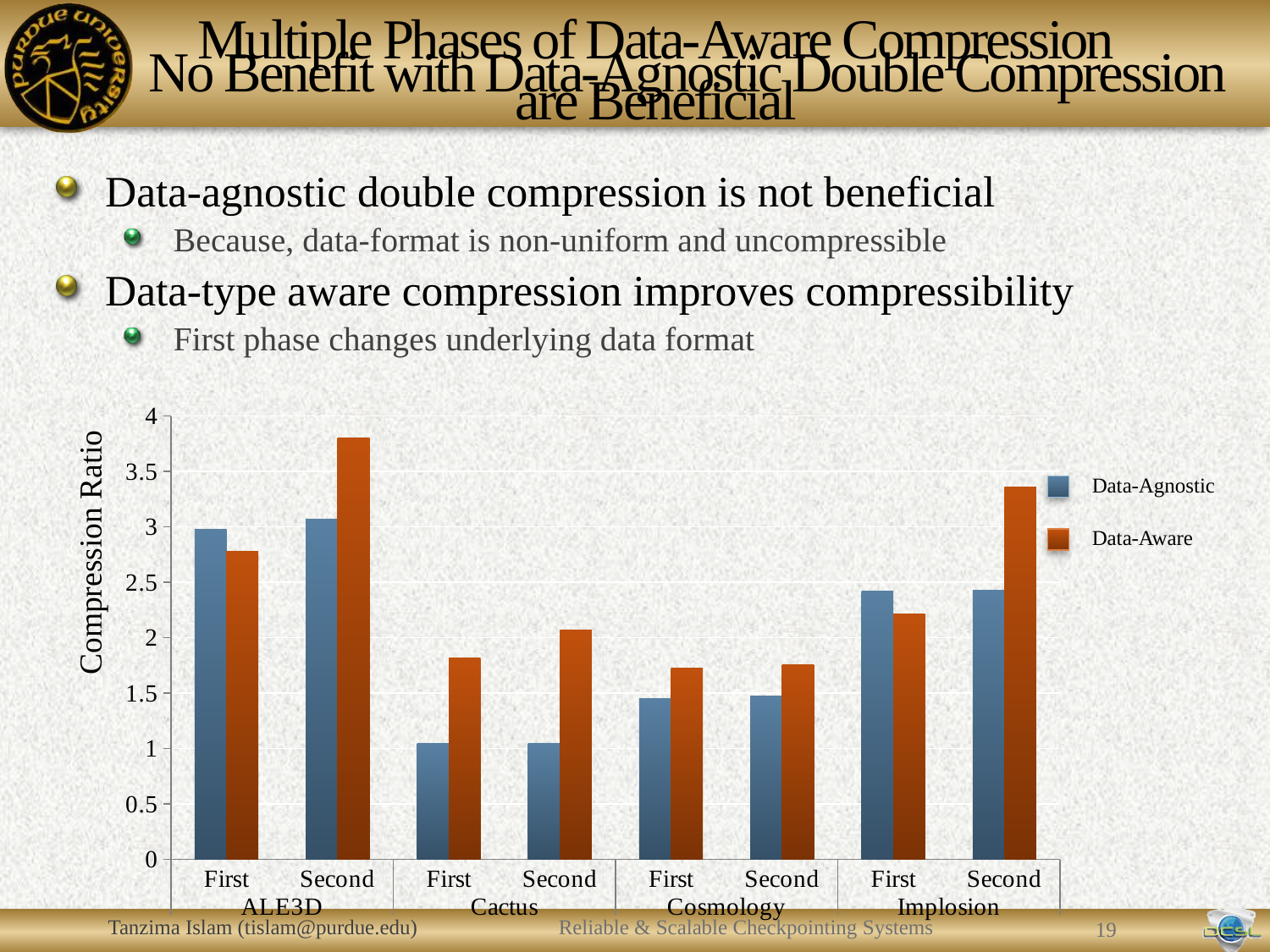
For ALE3D First, which series has the larger compression ratio, Data-Agnostic or Data-Aware? Data-Agnostic How many application groups (ALE3D, Cactus, etc.) are shown along the x axis? 4 Is the Data-Aware value for Implosion Second greater or less than 3? greater What is the label of the y axis? Compression Ratio Is the Data-Aware value for ALE3D Second greater or less than 3.5? greater Which colour represents the Data-Aware series in the legend? orange What kind of chart is shown on the slide? bar chart Is the Data-Agnostic value for Implosion First greater or less than 2.5? less How many series does the legend list? 2 For Implosion Second, which series has the larger compression ratio, Data-Agnostic or Data-Aware? Data-Aware Which bar has the highest compression ratio in the chart? Data-Aware, ALE3D Second